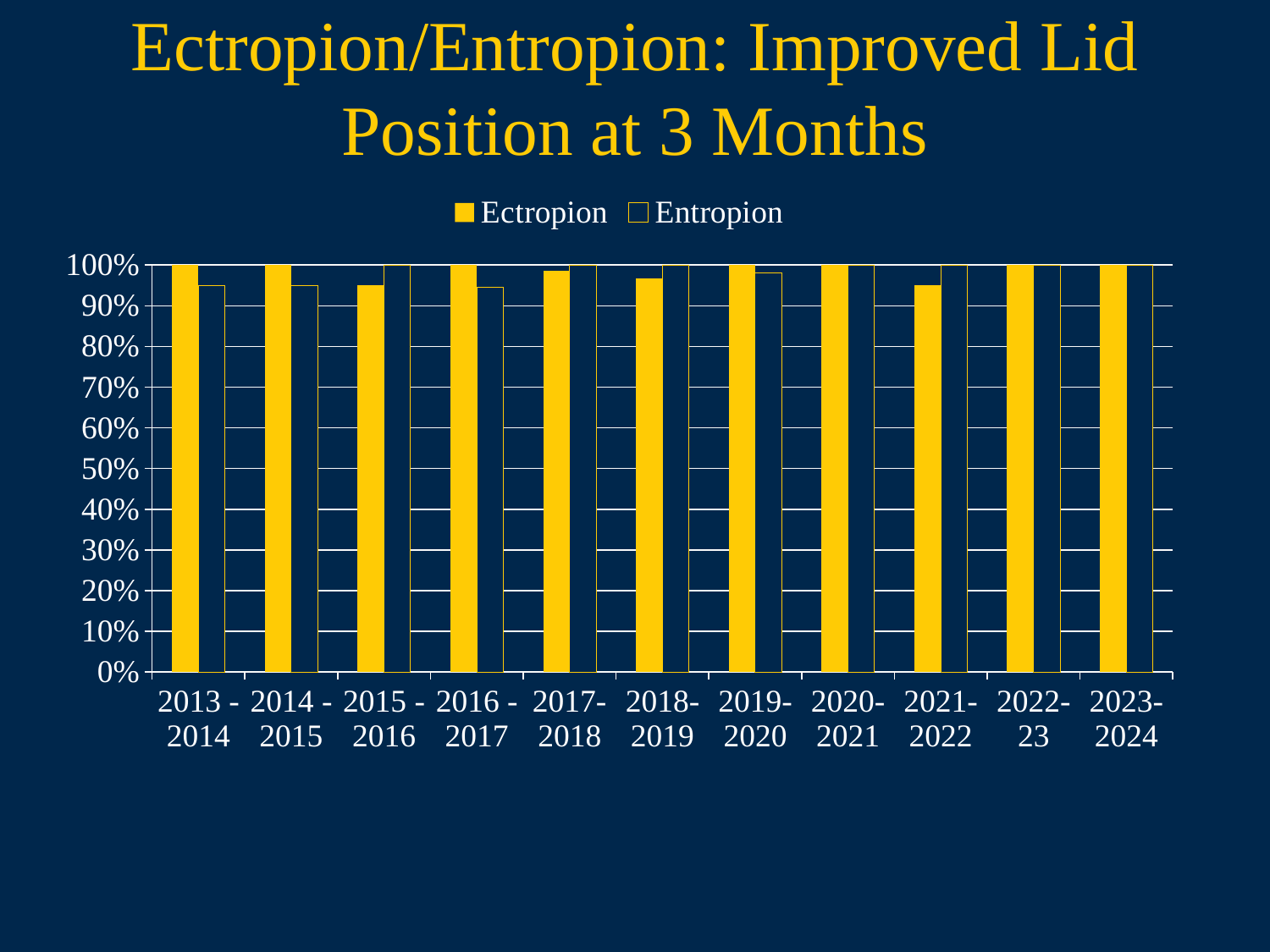
In 2015 - 2016, which series has the larger value, Ectropion or Entropion? Entropion How many year categories are shown on the x axis? 11 What is the value for Ectropion in 2013 - 2014? 100% Is the value for Ectropion in 2015 - 2016 greater or less than 90%? greater What kind of chart is shown on the slide? bar chart What are the two series named in the legend? Ectropion and Entropion In 2013 - 2014, which series has the larger value, Ectropion or Entropion? Ectropion Is the value for Entropion in 2013 - 2014 greater or less than 90%? greater What is the value for Ectropion in 2023-2024? 100% How many series does the legend list? 2 What is the title of the chart? Ectropion/Entropion: Improved Lid Position at 3 Months Is the value for Entropion in 2016 - 2017 greater or less than 80%? greater